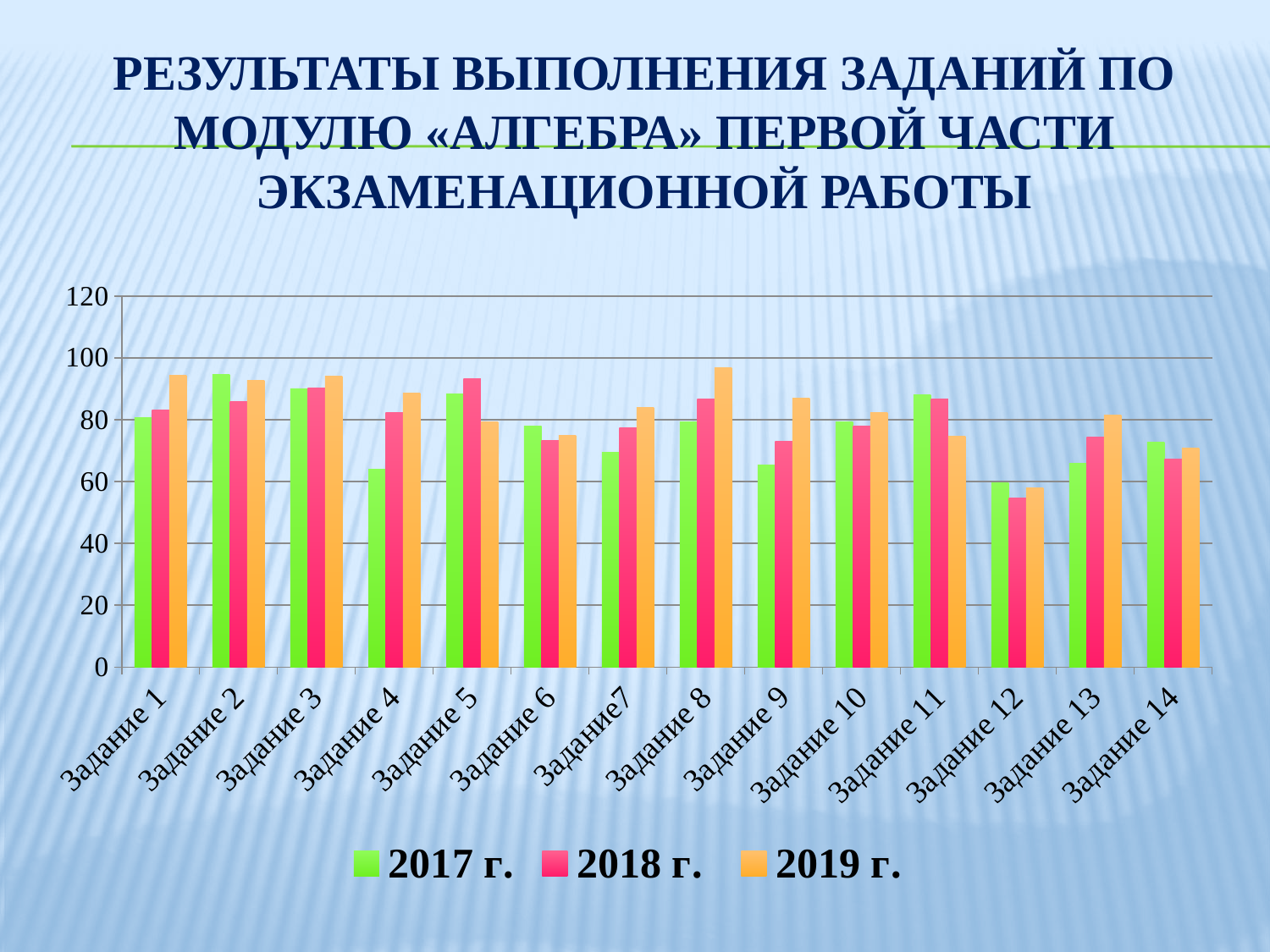
Is the value for 2017 г. on Задание 4 greater or less than 80? less Which task has the lowest value for the 2019 г. series? Задание 12 Is the value for 2019 г. on Задание 8 greater or less than 80? greater For Задание 5, which series has the larger value: 2018 г. or 2019 г.? 2018 г. How many tasks (categories) are shown on the x axis? 14 Which task has the lowest value for the 2018 г. series? Задание 12 Which task has the highest value for the 2017 г. series? Задание 2 What are the three entries listed in the legend? 2017 г., 2018 г., 2019 г. How many series does the legend list? 3 What kind of chart is shown on the slide? bar chart For Задание 4, which series has the larger value: 2017 г. or 2019 г.? 2019 г. Is the value for 2018 г. on Задание 12 greater or less than 60? less